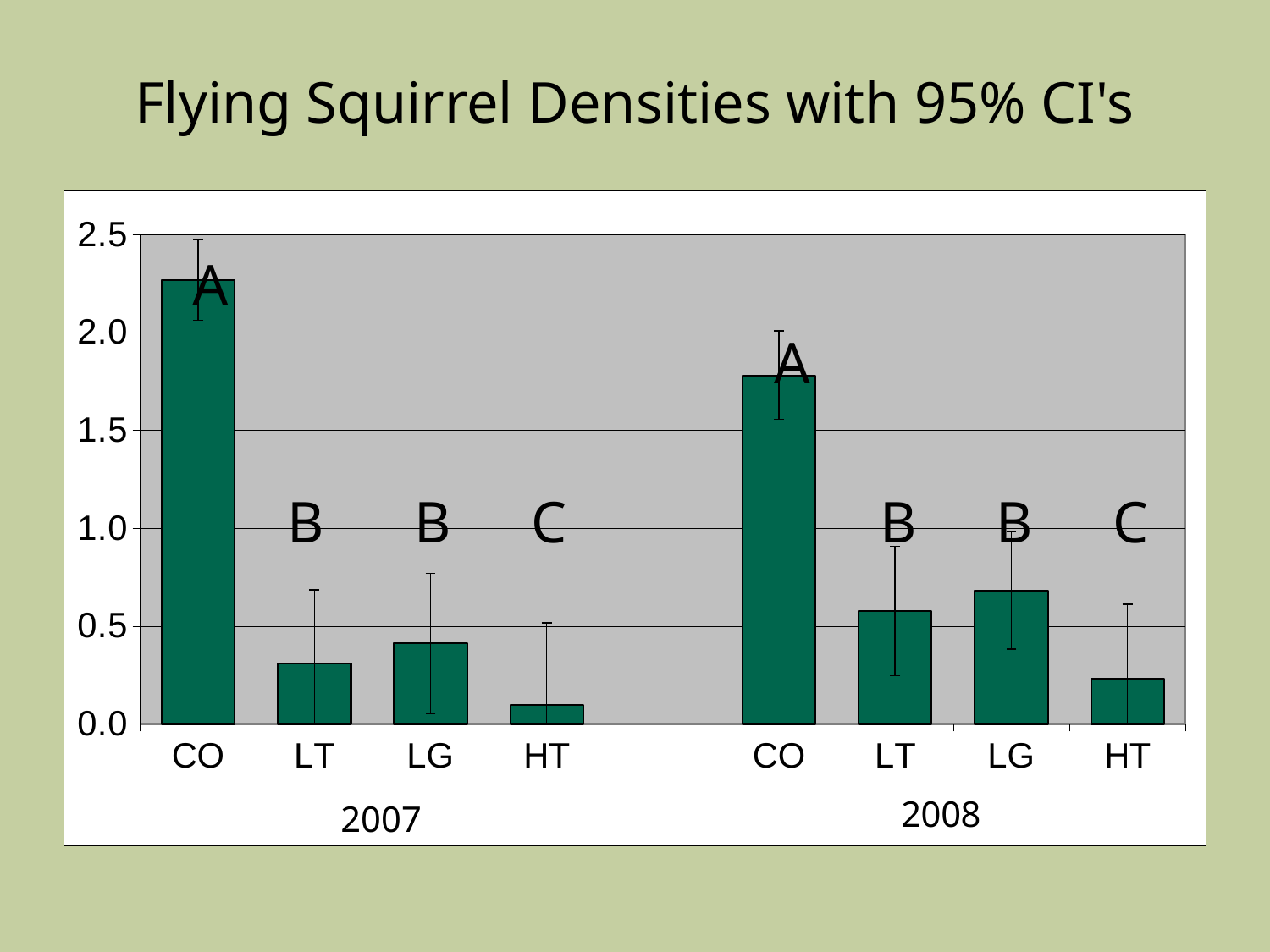
Is the value for LT in 2007 greater or less than 0.5? less Is the value for CO in 2007 greater or less than 2.0? greater What is the title of the chart? Flying Squirrel Densities with 95% CI's Is the value for LG in 2008 greater or less than 0.5? greater Which bar is the lowest in the chart? HT in 2007 Which is larger, the CO bar for 2007 or the CO bar for 2008? CO for 2007 Which bar is the highest in the chart? CO in 2007 Which letter is printed above the CO bars in both years? A What kind of chart is shown on the slide? bar chart Which is larger, the HT bar for 2007 or the HT bar for 2008? HT for 2008 How many bars are plotted in the chart? 8